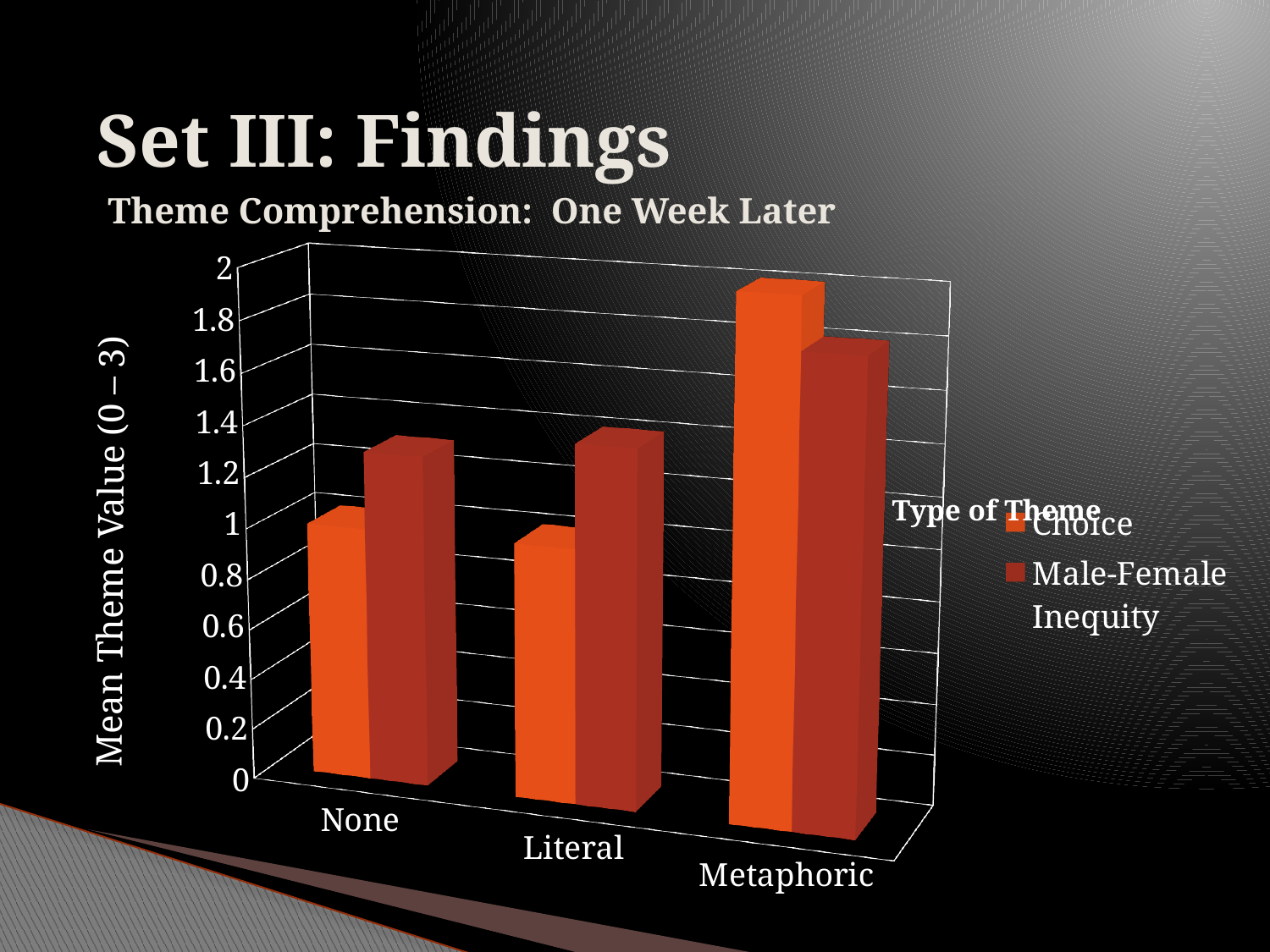
What is the label on the vertical axis of the chart? Mean Theme Value (0 – 3) Which category has the highest value for the Choice series? Metaphoric What type of chart is shown on the slide? bar chart Which category has the highest value for the Male-Female Inequity series? Metaphoric For the Metaphoric category, which series has the larger value, Choice or Male-Female Inequity? Choice What is the title of the chart? Theme Comprehension: One Week Later Is the Male-Female Inequity value for Literal greater or less than 1? greater How many series does the chart's legend list? 2 How many categories are shown on the x axis of the chart? 3 For the None category, which series has the larger value, Choice or Male-Female Inequity? Male-Female Inequity Is the Choice value for None greater or less than 1.4? less Is the Choice value for Metaphoric greater or less than 1.6? greater